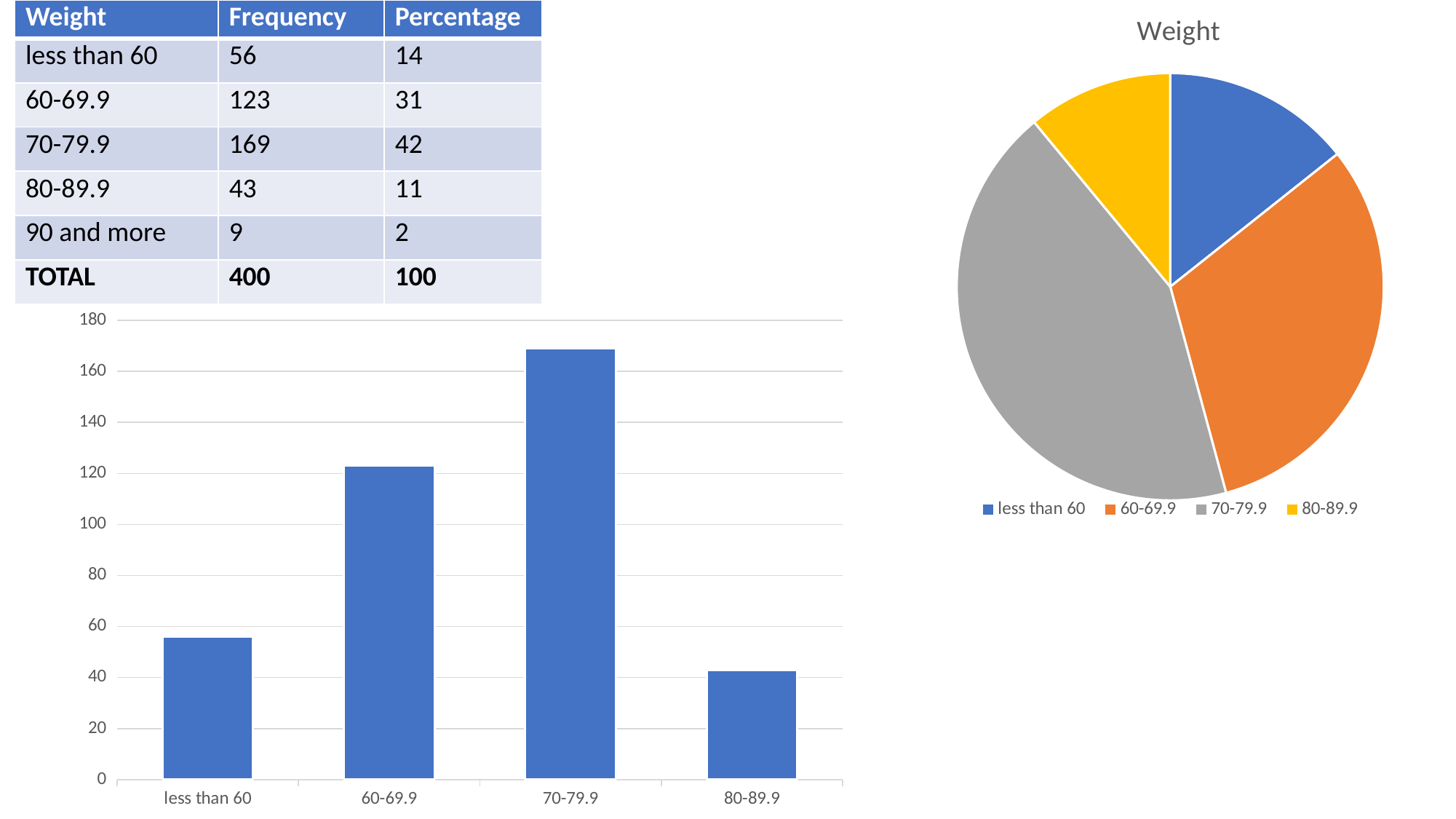
In the bar chart at the bottom left, which category has the shortest bar? 80-89.9 What kind of chart is the chart titled "Weight" on the right of the slide? pie chart In the bar chart at the bottom left, which bar is taller: less than 60 or 60-69.9? 60-69.9 In the bar chart at the bottom left, is the value for 60-69.9 greater or less than 100? greater In the bar chart at the bottom left, which category has the tallest bar? 70-79.9 In the pie chart titled "Weight", how many categories does the legend list? 4 What kind of chart is shown at the bottom left of the slide? bar chart In the bar chart at the bottom left, is the value for 80-89.9 greater or less than 60? less In the bar chart at the bottom left, how many categories are shown on the x axis? 4 In the bar chart at the bottom left, is the value for 70-79.9 greater or less than 160? greater In the pie chart titled "Weight", what colour is the slice for 60-69.9? orange In the pie chart titled "Weight", which category has the largest slice? 70-79.9